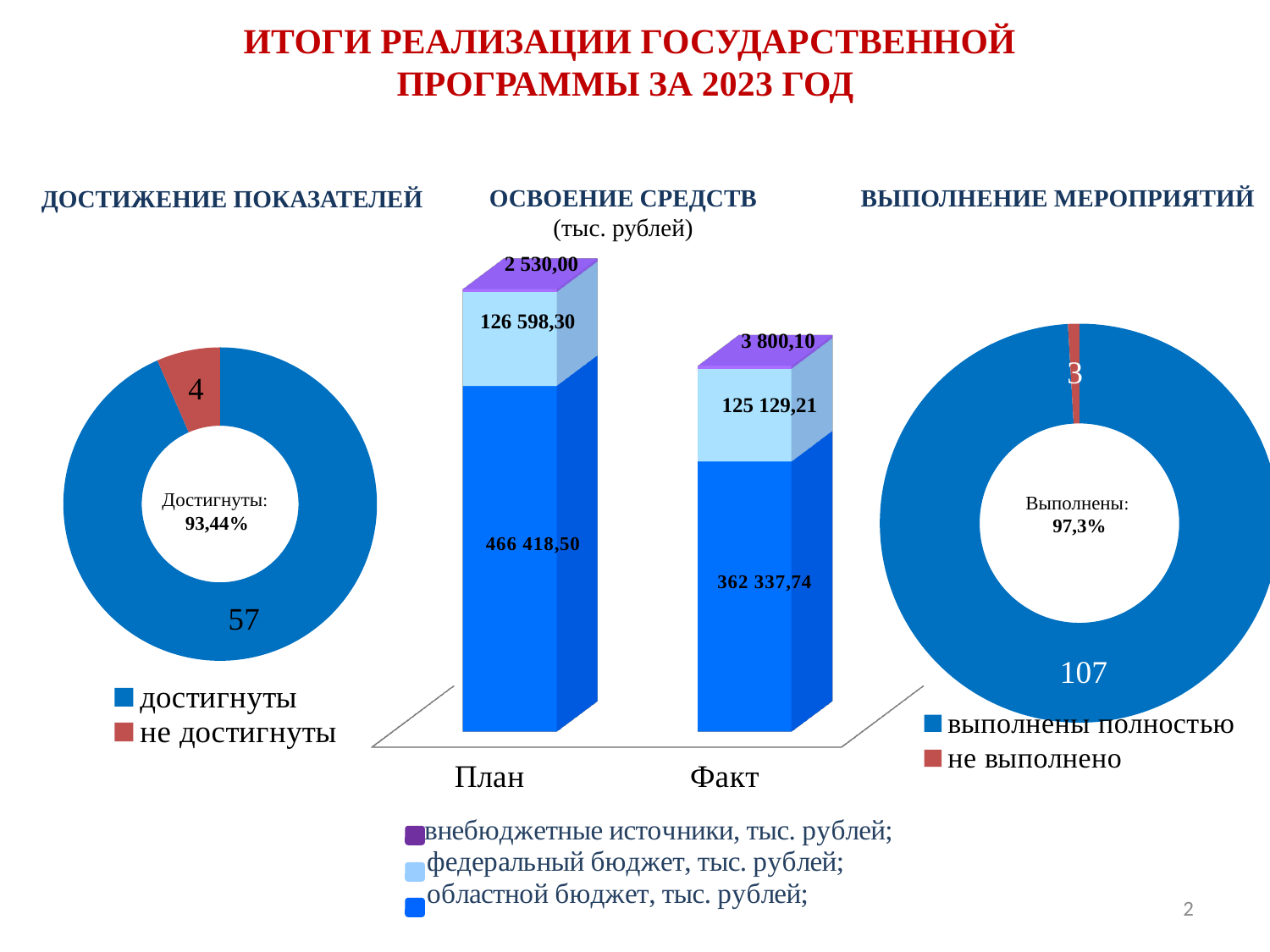
In the chart titled ВЫПОЛНЕНИЕ МЕРОПРИЯТИЙ, how many activities are marked выполнены полностью? 107 In the chart titled ОСВОЕНИЕ СРЕДСТВ, what is the value of областной бюджет for План? 466 418,50 In the chart titled ДОСТИЖЕНИЕ ПОКАЗАТЕЛЕЙ, how many indicators are marked не достигнуты? 4 In the chart titled ДОСТИЖЕНИЕ ПОКАЗАТЕЛЕЙ, what share of indicators is shown as Достигнуты in the centre of the doughnut? 93,44% In the chart titled ОСВОЕНИЕ СРЕДСТВ, what is the value of внебюджетные источники for Факт? 3 800,10 What kind of chart is the one titled ОСВОЕНИЕ СРЕДСТВ? Stacked bar chart In the chart titled ОСВОЕНИЕ СРЕДСТВ, what is the total of the План bar? 595 546,80 In the chart titled ДОСТИЖЕНИЕ ПОКАЗАТЕЛЕЙ, how many indicators are marked достигнуты? 57 In the chart titled ОСВОЕНИЕ СРЕДСТВ, what is the difference between План and Факт for областной бюджет? 104 080,76 In the chart titled ОСВОЕНИЕ СРЕДСТВ, how many series does the legend list? 3 In the chart titled ОСВОЕНИЕ СРЕДСТВ, which is larger for федеральный бюджет: План or Факт? План In the chart titled ОСВОЕНИЕ СРЕДСТВ, what is the total of the Факт bar? 491 267,05